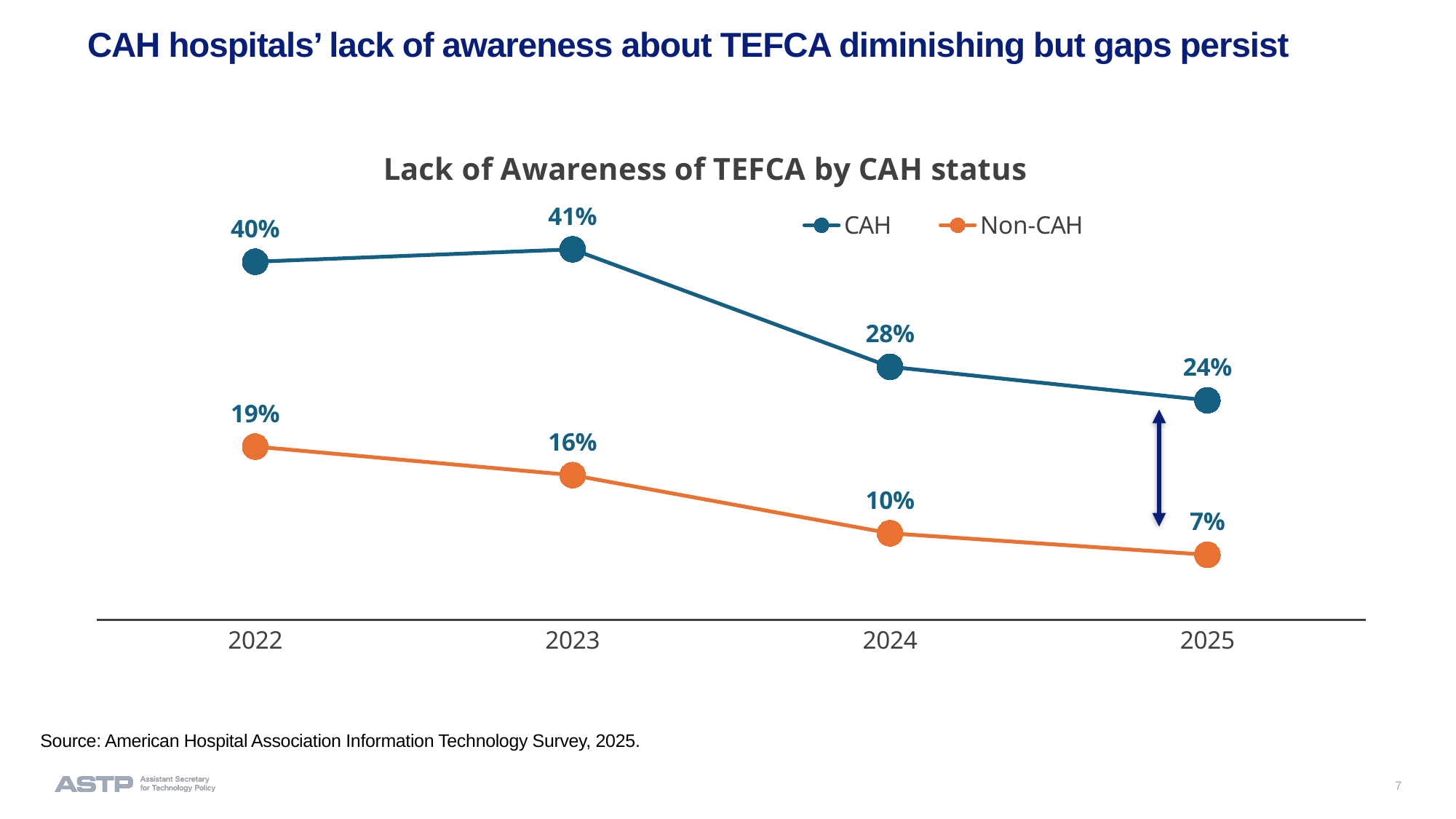
What is the value for CAH in 2022? 40% Does the Non-CAH series rise or fall from 2022 to 2025? Fall What is the difference between the CAH values in 2023 and 2024? 13% In which year is the Non-CAH value lowest? 2025 What is the difference between the CAH and Non-CAH values in 2025? 17% How many years are shown on the x axis? 4 In which year is the CAH value highest? 2023 How many series does the legend list? 2 Which is larger, the CAH value in 2024 or the Non-CAH value in 2022? CAH value in 2024 What is the value for Non-CAH in 2025? 7% What kind of chart is this? Line chart What is the value for Non-CAH in 2024? 10%